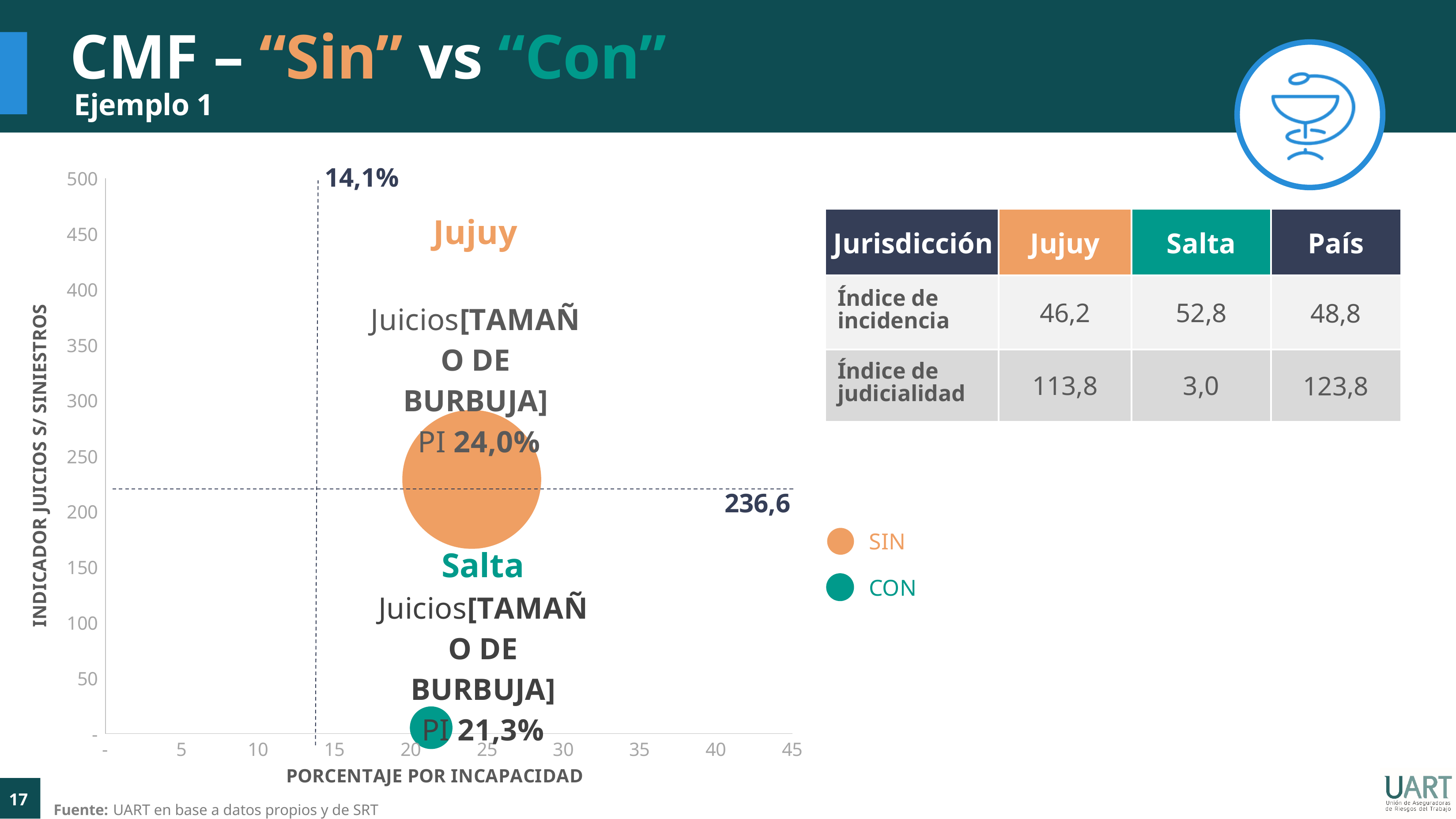
What is the PI value labelled on the Salta bubble? 21,3% What is the PI value labelled on the Jujuy bubble? 24,0% What value is labelled on the horizontal dashed reference line of the chart? 236,6 What kind of chart is shown on the slide? bubble chart What are the two entries in the chart legend? SIN and CON How many bubbles are plotted on the chart? 2 Is the Jujuy bubble's value on the vertical axis (Indicador juicios s/ siniestros) greater or less than 300? less Which jurisdiction has the higher PI value, Jujuy or Salta? Jujuy What is the difference between the PI values of Jujuy (24,0%) and Salta (21,3%)? 2,7% How many series does the legend list? 2 Is the Salta bubble's value on the vertical axis (Indicador juicios s/ siniestros) greater or less than 50? less What is the title of the horizontal axis of the chart? PORCENTAJE POR INCAPACIDAD